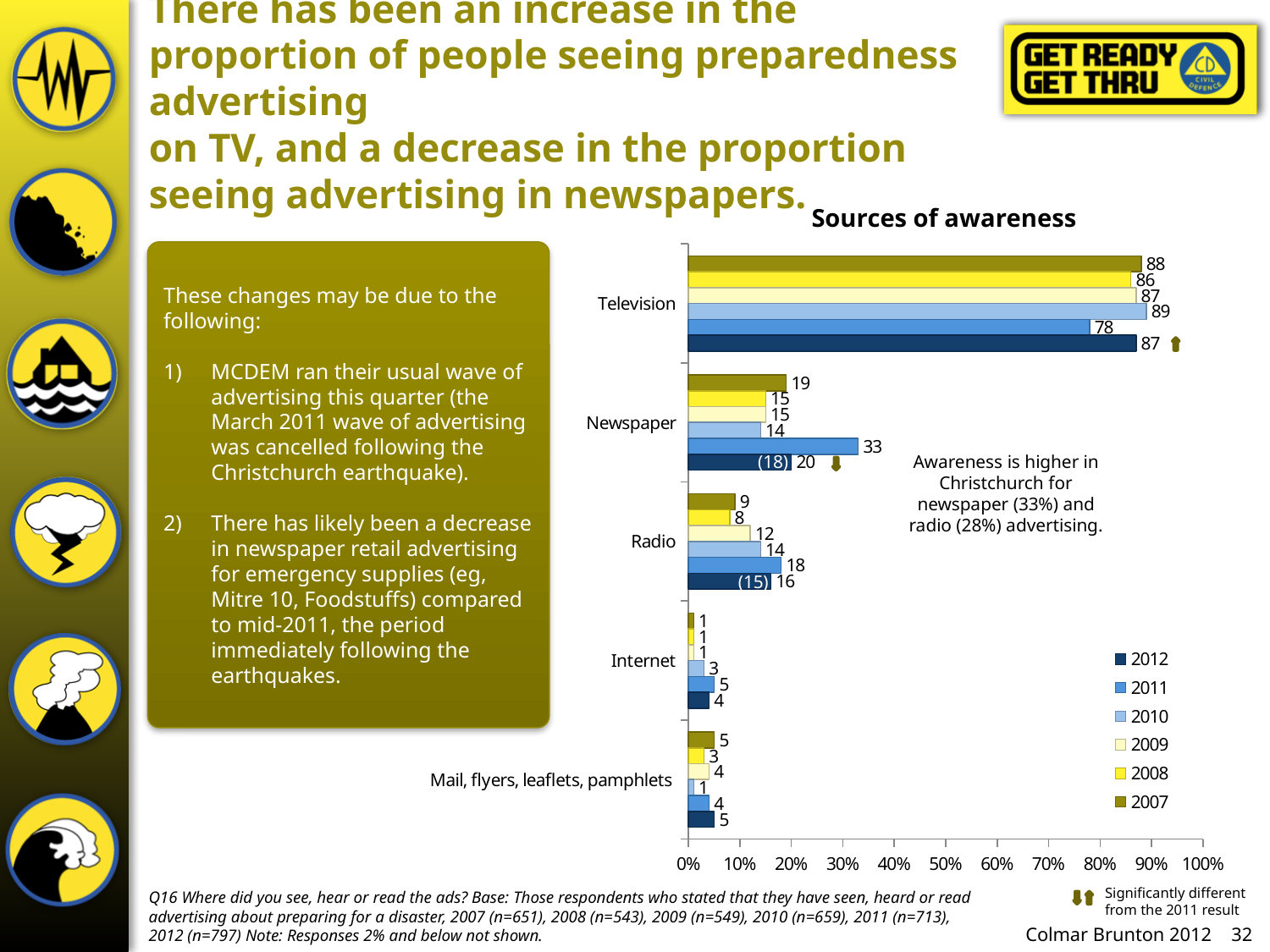
What kind of chart is the Sources of awareness chart? bar chart In the Sources of awareness chart, what is the value for Radio in 2010? 14 How many series does the legend of the Sources of awareness chart list? 6 In the Sources of awareness chart, what is the value for Newspaper in 2011? 33 In the Sources of awareness chart, which year has the highest value for Television? 2010 In the Sources of awareness chart, what is the difference between the Newspaper values for 2011 and 2012? 13 In the Sources of awareness chart, what is the value for Television in 2012? 87 How many source categories are shown in the Sources of awareness chart? 5 In the Sources of awareness chart, did the Newspaper value rise or fall from 2011 to 2012? fall In the Sources of awareness chart, which year has the larger Radio value, 2011 or 2012? 2011 In the Sources of awareness chart, which year has the lowest value for Television? 2011 In the Sources of awareness chart, is the value for Television in 2011 greater or less than 80%? less